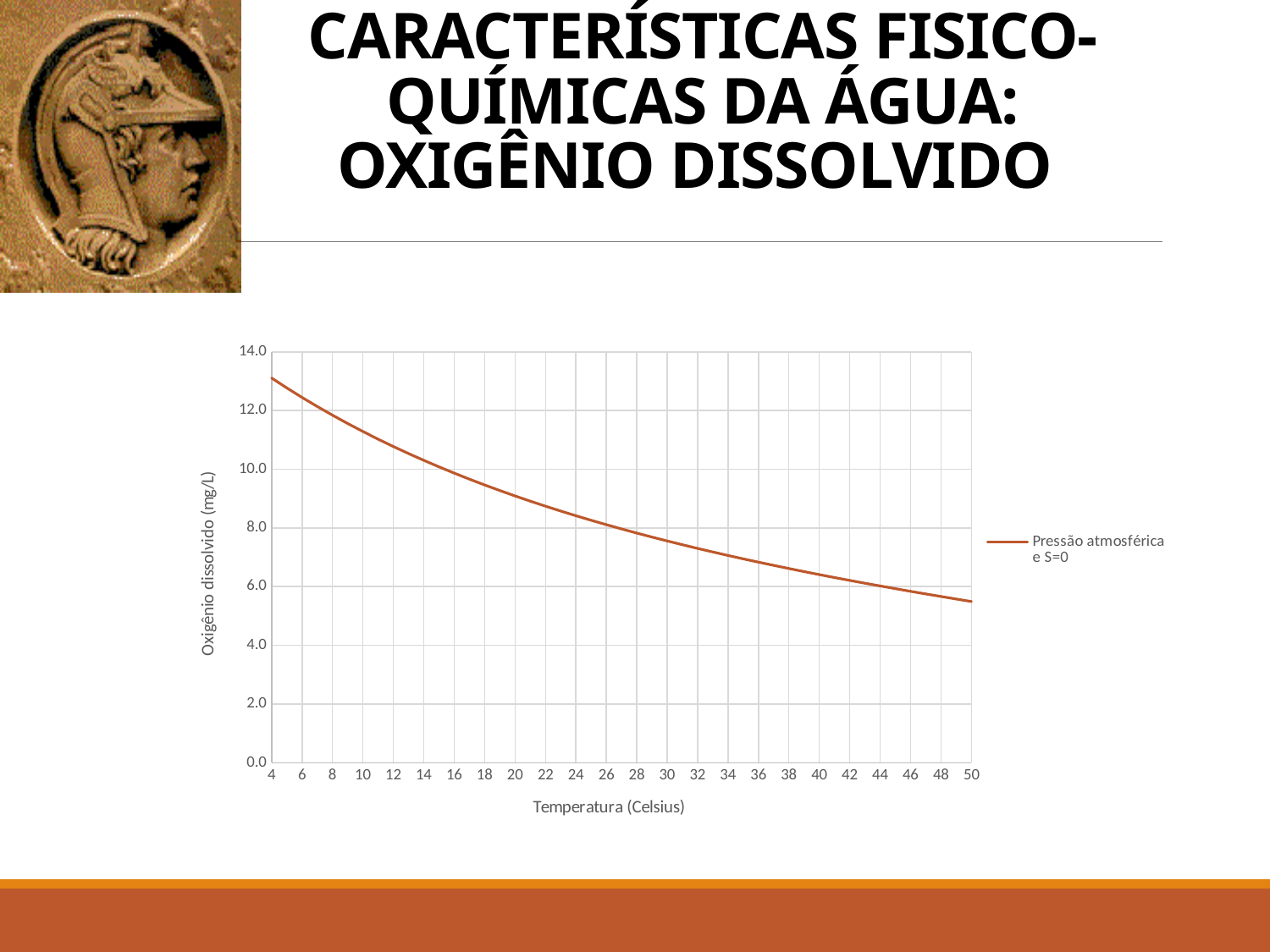
At which temperature on the x axis is the dissolved oxygen value lowest? 50 At which temperature on the x axis is the dissolved oxygen value highest? 4 What kind of chart is shown on the slide? line chart Which has the larger dissolved oxygen value, 10 °C or 40 °C? 10 °C What is the name of the series shown in the chart legend? Pressão atmosférica e S=0 Does the dissolved oxygen value rise or fall as temperature increases along the x axis? fall Is the dissolved oxygen value at 20 °C greater or less than 8.0? greater Is the dissolved oxygen value at 36 °C greater or less than 8.0? less What is the title of the chart's x axis? Temperatura (Celsius) Is the dissolved oxygen value at 4 °C greater or less than 12.0? greater How many series does the chart legend list? 1